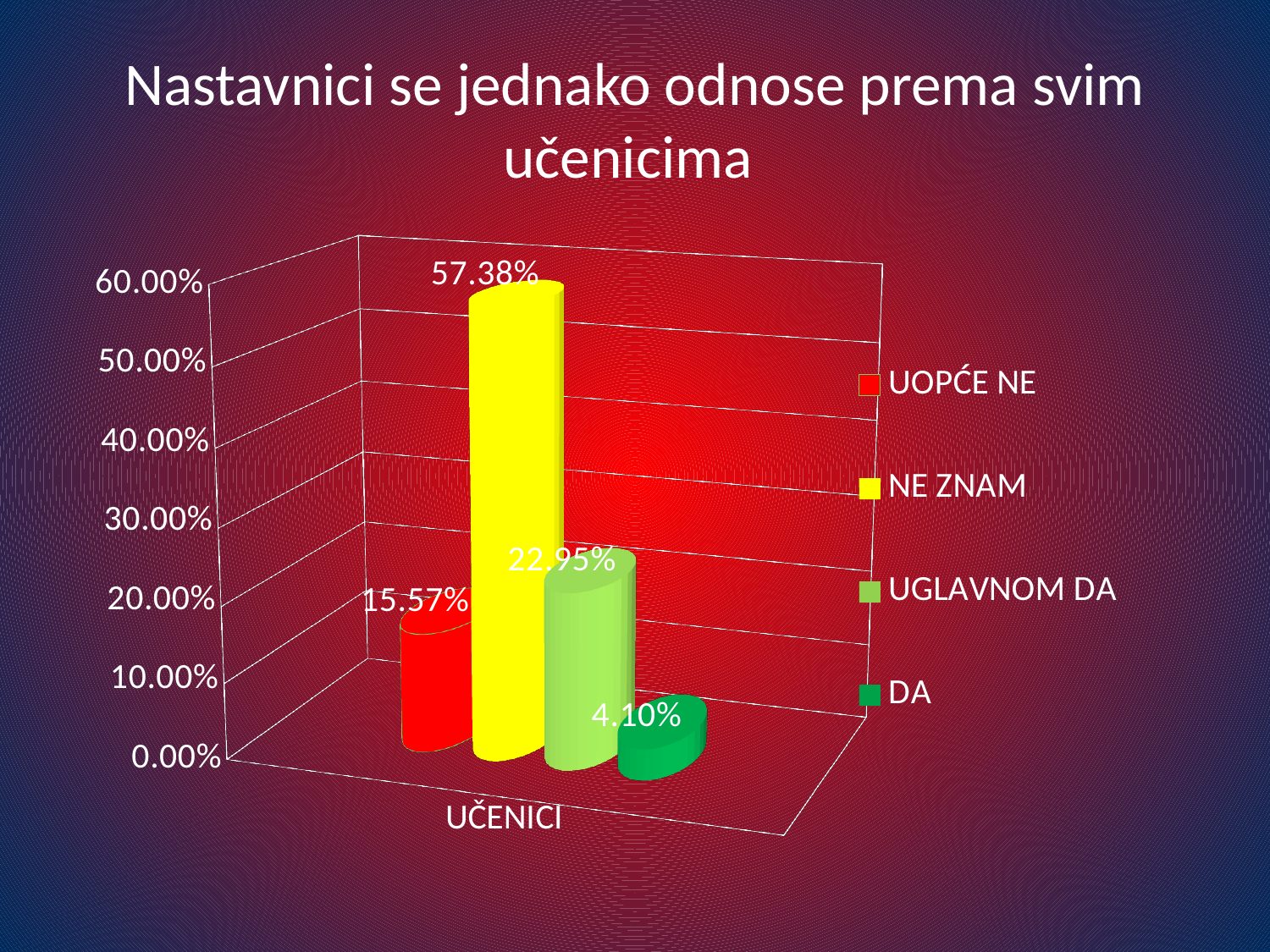
What is the value for DA? 4.10% Is the value for NE ZNAM greater or less than 50.00%? greater What is the value for UGLAVNOM DA? 22.95% Which series has the lowest value? DA What is the value for NE ZNAM? 57.38% What is the category label shown on the x axis? UČENICI What is the value for UOPĆE NE? 15.57% Which series has the highest value? NE ZNAM What kind of chart is shown on the slide? bar chart Which is larger, the value for UOPĆE NE or the value for UGLAVNOM DA? UGLAVNOM DA How many series does the legend list? 4 What is the difference between the values for NE ZNAM and UGLAVNOM DA? 34.43%